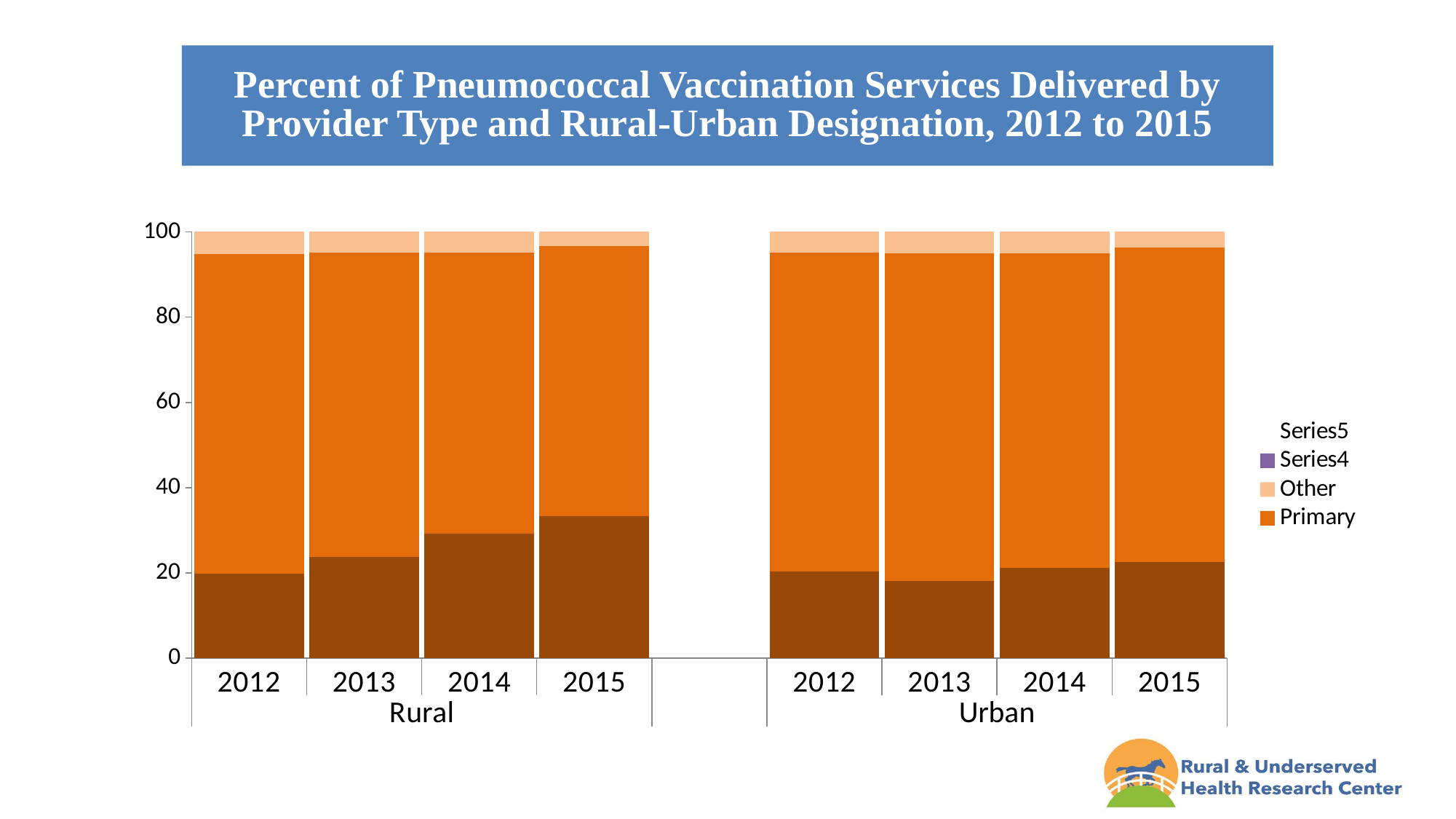
Which has the larger bottom dark brown segment: Rural 2015 or Urban 2015? Rural 2015 Is the top of the bottom dark brown segment for Urban 2013 greater or less than 20? less What is the title of the chart? Percent of Pneumococcal Vaccination Services Delivered by Provider Type and Rural-Urban Designation, 2012 to 2015 Among the Urban bars, which year has the smallest bottom dark brown segment? 2013 What kind of chart is shown on the slide? Stacked bar chart How many entries does the chart legend list? 4 How many bars are plotted in the chart in total? 8 What are the two group labels shown beneath the years on the x axis? Rural and Urban Among the Rural bars, which year has the largest bottom dark brown segment? 2015 Does the bottom dark brown segment of the Rural bars rise or fall from 2012 to 2015? Rise Is the top of the bottom dark brown segment for Rural 2014 greater or less than 20? greater Is the top of the bottom dark brown segment for Rural 2015 greater or less than 30? greater